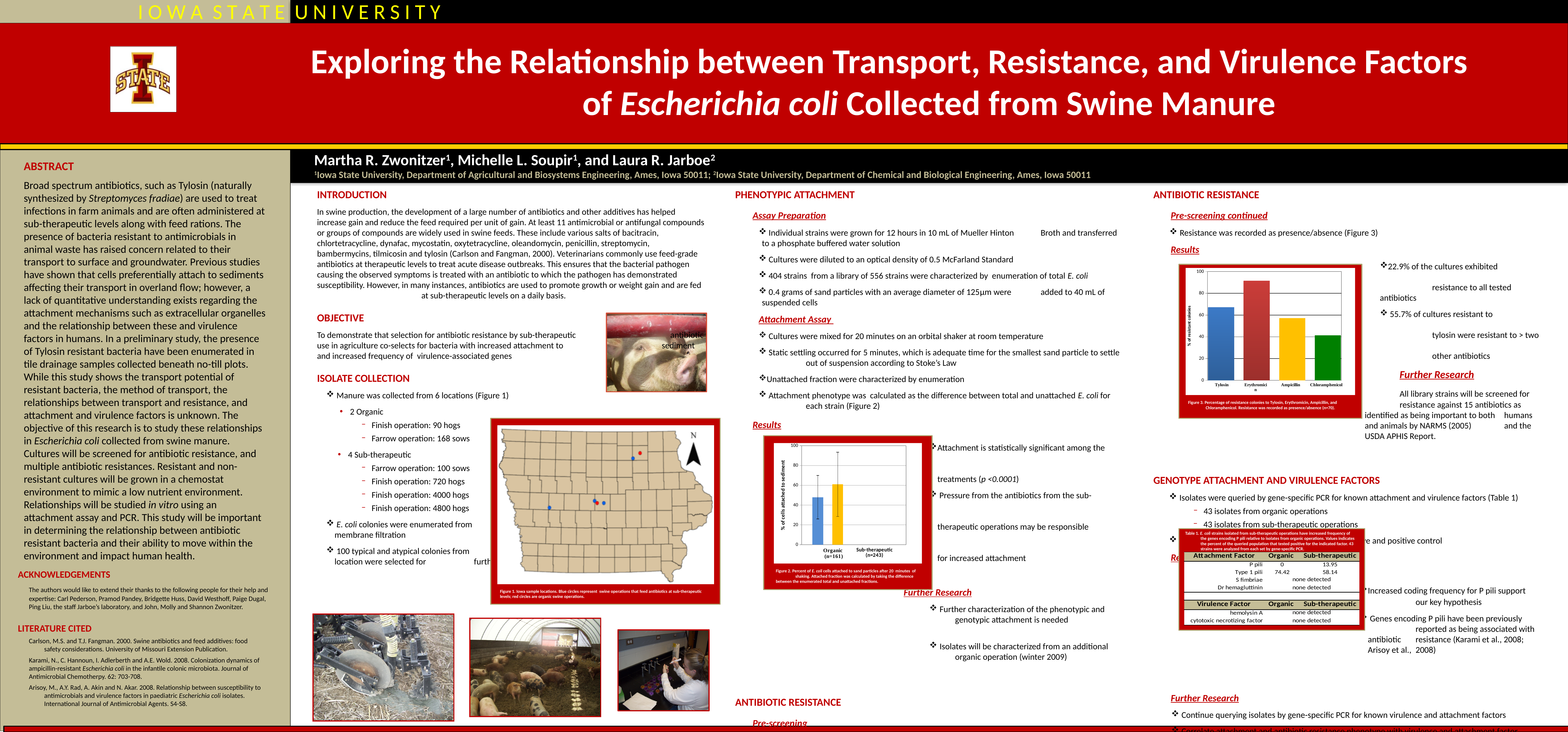
In Figure 3 (the antibiotic resistance chart), how many antibiotics are shown on the x axis? 4 In Figure 3 (the antibiotic resistance chart), what is the label of the y axis? % of resistant colonies In Figure 2 (the attachment chart), which group has a higher percentage of cells attached to sediment, Organic or Sub-therapeutic? Sub-therapeutic In Figure 2 (the attachment chart), how many groups are plotted on the x axis? 2 In Figure 3 (the antibiotic resistance chart), is the value for Tylosin greater or less than 60? greater In Figure 3 (the antibiotic resistance chart), which antibiotic has the highest percentage of resistant colonies? Erythromicin In Figure 3 (the antibiotic resistance chart), which antibiotic has the lowest percentage of resistant colonies? Chloramphenicol In Figure 3 (the antibiotic resistance chart), is the value for Chloramphenicol greater or less than 60? less In Figure 2 (the attachment chart), is the value for Organic (n=161) greater or less than 60? less What kind of chart is Figure 3 (the antibiotic resistance chart)? Bar chart In Figure 3 (the antibiotic resistance chart), which has a higher percentage of resistant colonies, Tylosin or Ampicillin? Tylosin